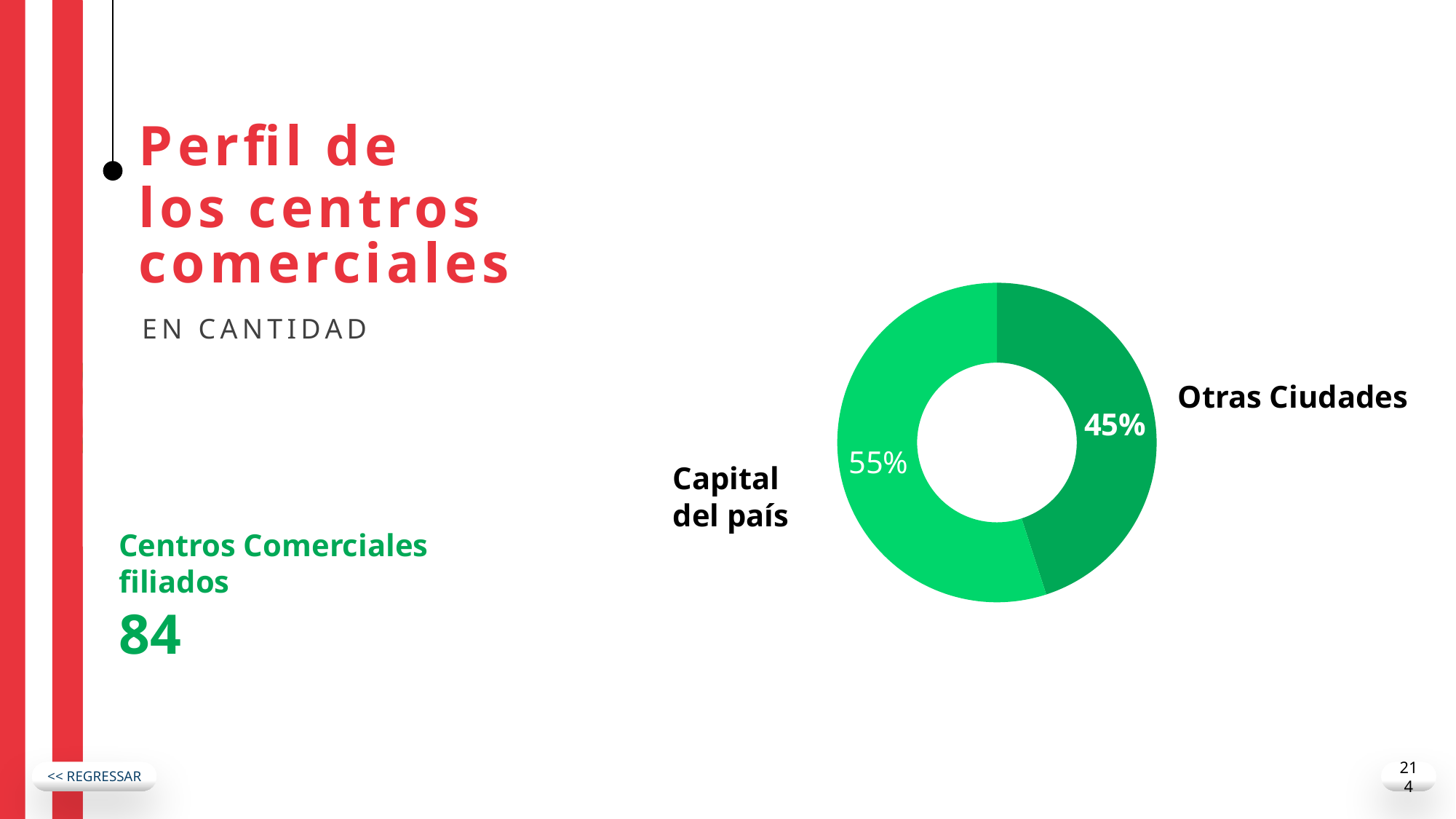
What share of the donut chart is labelled "Otras Ciudades"? 45% Which segment of the donut chart is the smallest? Otras Ciudades Which segment of the donut chart is the largest? Capital del país What number of "Centros Comerciales filiados" is shown on the slide? 84 How many segments does the donut chart have? 2 Is the share for "Otras Ciudades" greater or less than 50%? less What kind of chart is shown on the slide? Donut (pie) chart What is the total of the two segments shown in the donut chart? 100% What is the subtitle shown under the slide title "Perfil de los centros comerciales"? EN CANTIDAD What share of the donut chart is labelled "Capital del país"? 55% Which is larger, the "Capital del país" segment or the "Otras Ciudades" segment? Capital del país What is the difference in percentage points between the "Capital del país" and "Otras Ciudades" segments? 10